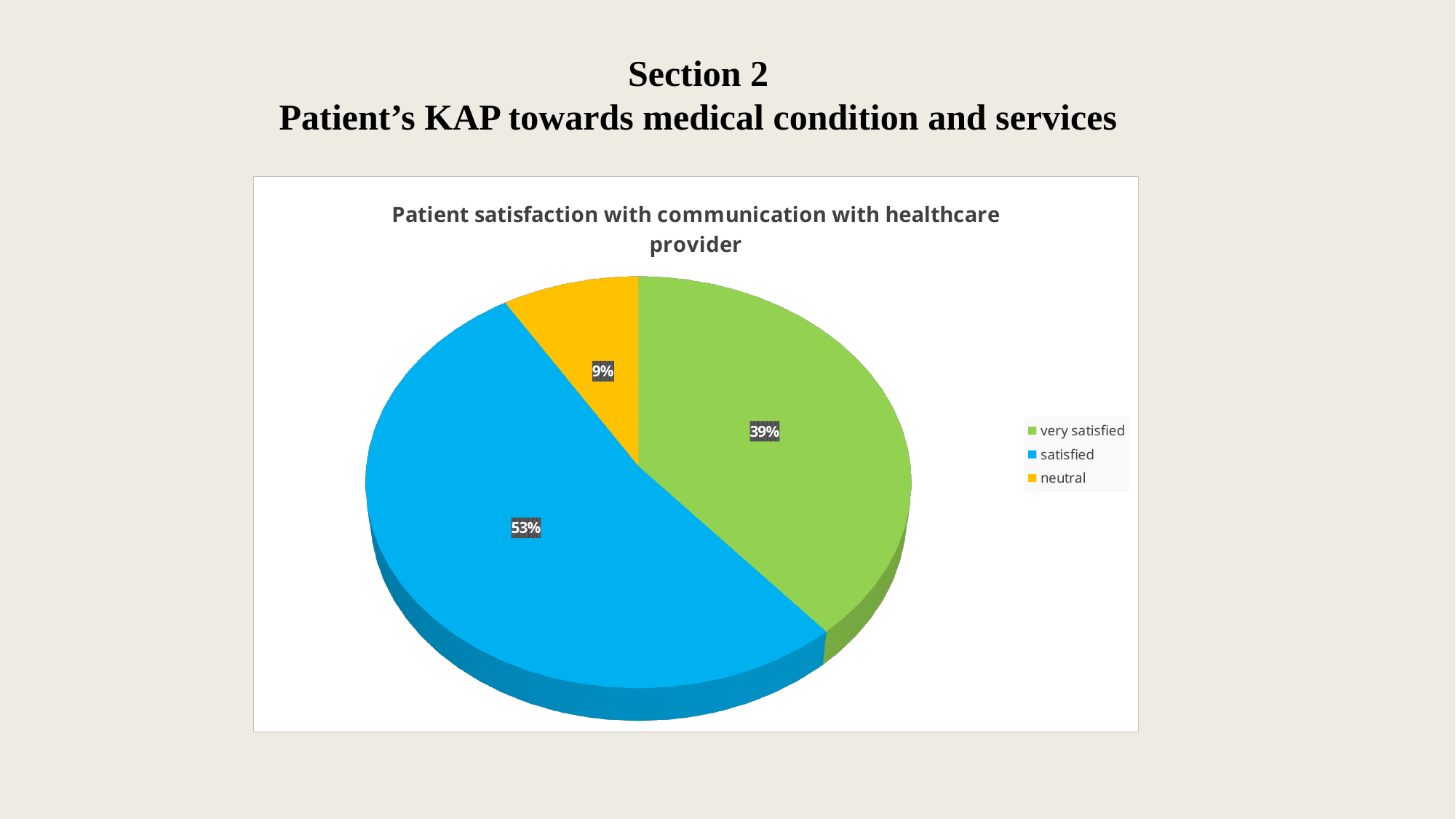
What percentage of patients were very satisfied with communication with their healthcare provider? 39% How many categories are shown in the pie chart? 3 What percentage of patients were neutral about communication with their healthcare provider? 9% Which category has the smallest share of the pie? neutral Which category has the largest share of the pie? satisfied What kind of chart is shown on the slide? pie chart What is the difference in percentage points between the satisfied and very satisfied slices? 14 Which is larger, the very satisfied slice or the neutral slice? very satisfied What is the difference in percentage points between the very satisfied and neutral slices? 30 What percentage of patients were satisfied with communication with their healthcare provider? 53% Which colour represents the satisfied category in the pie chart? blue What is the title of the chart? Patient satisfaction with communication with healthcare provider